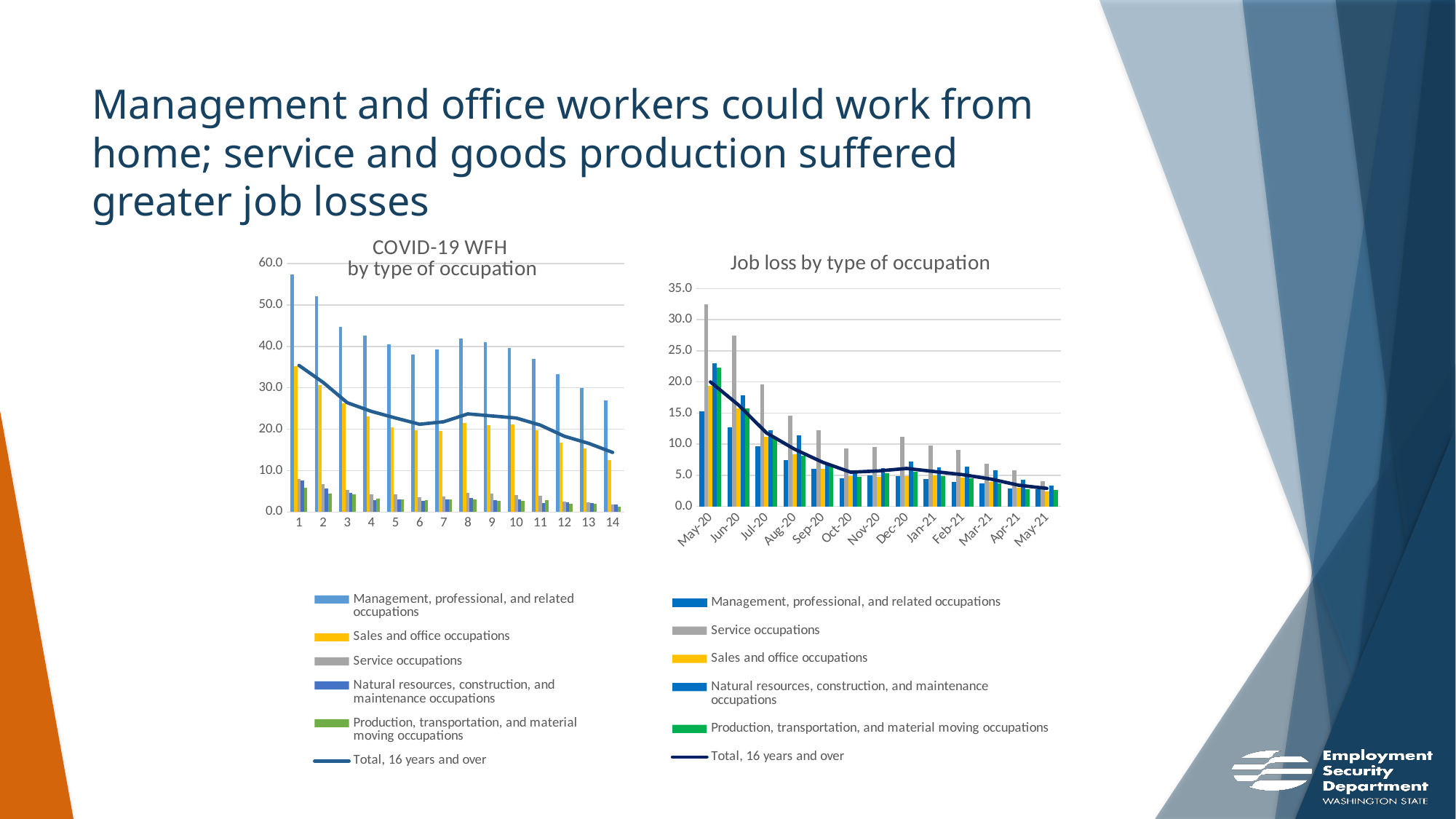
In the 'Job loss by type of occupation' chart, is the Total, 16 years and over value for May-21 greater or less than 5? less In the 'COVID-19 WFH by type of occupation' chart, is the value for Management, professional, and related occupations at category 1 greater or less than 50? greater In the 'COVID-19 WFH by type of occupation' chart, which is larger at category 1: Management, professional, and related occupations or Sales and office occupations? Management, professional, and related occupations What is the title of the chart on the right side of the slide? Job loss by type of occupation In the 'Job loss by type of occupation' chart, does the Total, 16 years and over line generally rise or fall from May-20 to May-21? fall In the 'Job loss by type of occupation' chart, which month has the highest value for Service occupations? May-20 In the 'Job loss by type of occupation' chart, is the value for Service occupations in May-20 greater or less than 30? greater How many series does the legend of the 'COVID-19 WFH by type of occupation' chart list? 6 How many categories are shown on the x axis of the 'Job loss by type of occupation' chart? 13 How many categories are shown on the x axis of the 'COVID-19 WFH by type of occupation' chart? 14 In the 'Job loss by type of occupation' chart, which is larger in May-20: Service occupations or Management, professional, and related occupations? Service occupations What kind of chart is the 'Job loss by type of occupation' chart? bar chart with a line